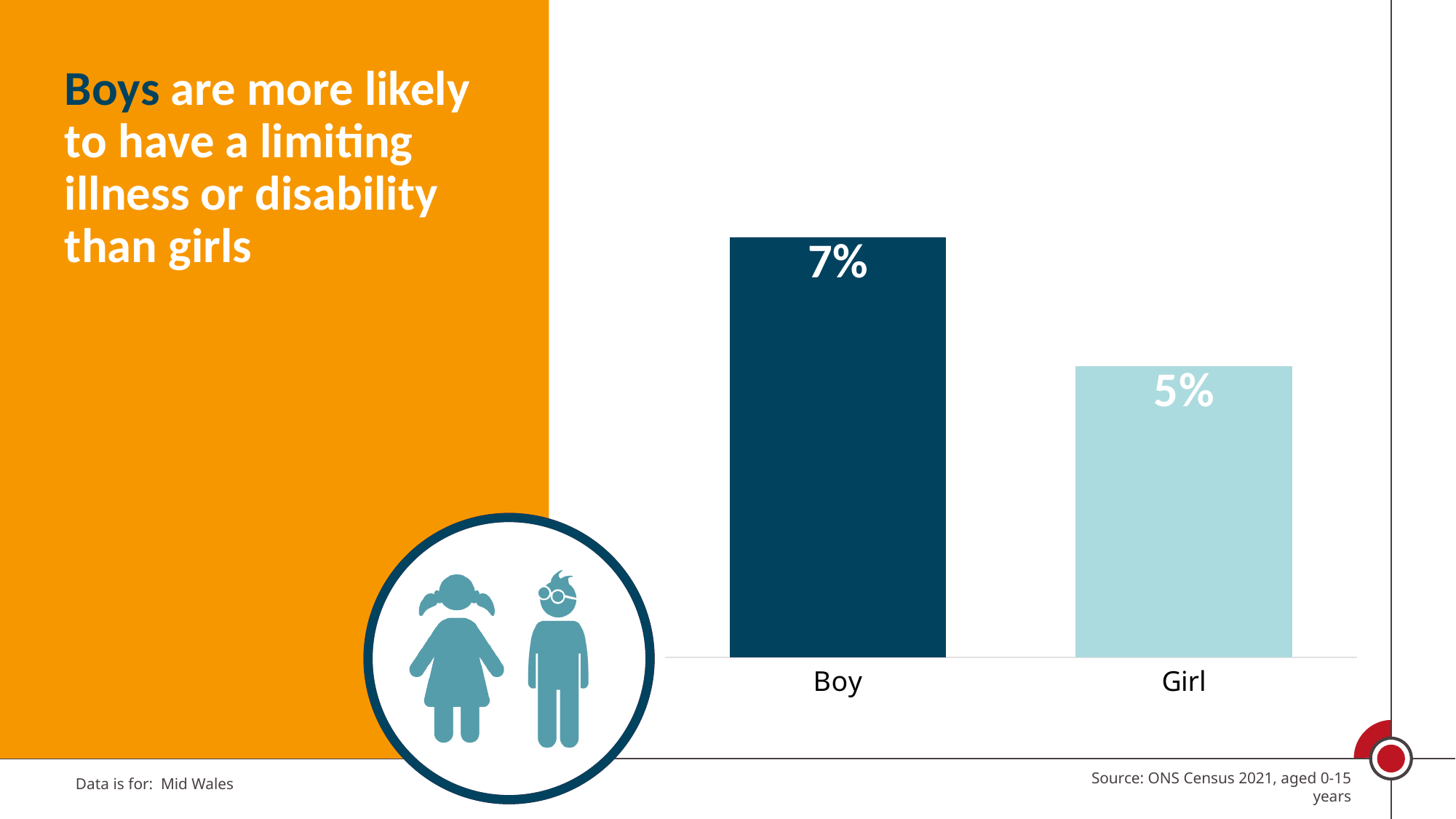
How many categories are shown in the chart? 2 Which category has the highest value? Boy What area is the data for, according to the slide? Mid Wales What is the difference between the values for Boy and Girl? 2% What kind of chart is shown on the slide? Bar chart Which category has the lowest value? Girl What is the value for Boy? 7% Do the values rise or fall from Boy to Girl along the x axis? Fall Which is larger, the value for Boy or the value for Girl? Boy What is the value for Girl? 5% What is the source of the data shown in the chart? ONS Census 2021, aged 0-15 years